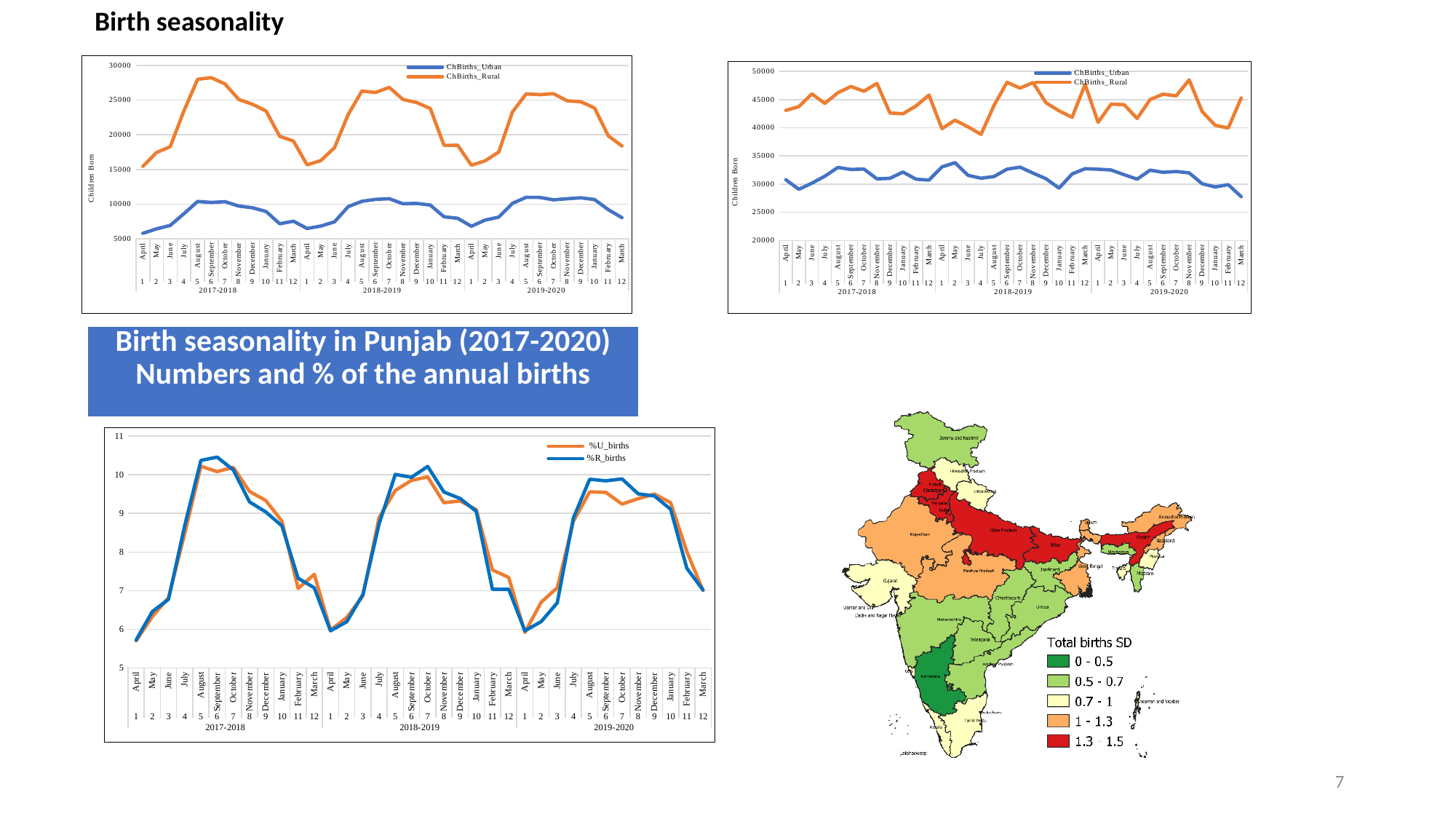
What are the two series named in the legend of the top-left chart? ChBirths_Urban and ChBirths_Rural In the top-right chart, is the value for ChBirths_Urban in March of 2019-2020 greater or less than 30000? less In the bottom-left chart, do the %U_births values rise or fall from April to September of 2017-2018? rise In the top-left chart, is the value for ChBirths_Rural in September of 2017-2018 greater or less than 25000? greater How many series does the legend of the top-left chart list? 2 In the bottom-left chart, is the value for %R_births in September of 2017-2018 greater or less than 10? greater How many series does the legend of the bottom-left chart list? 2 What kind of chart is the top-left chart on the slide? line chart What is the y-axis label of the top-right chart? Children Born In the top-left chart, which series is higher in September of 2017-2018, ChBirths_Urban or ChBirths_Rural? ChBirths_Rural